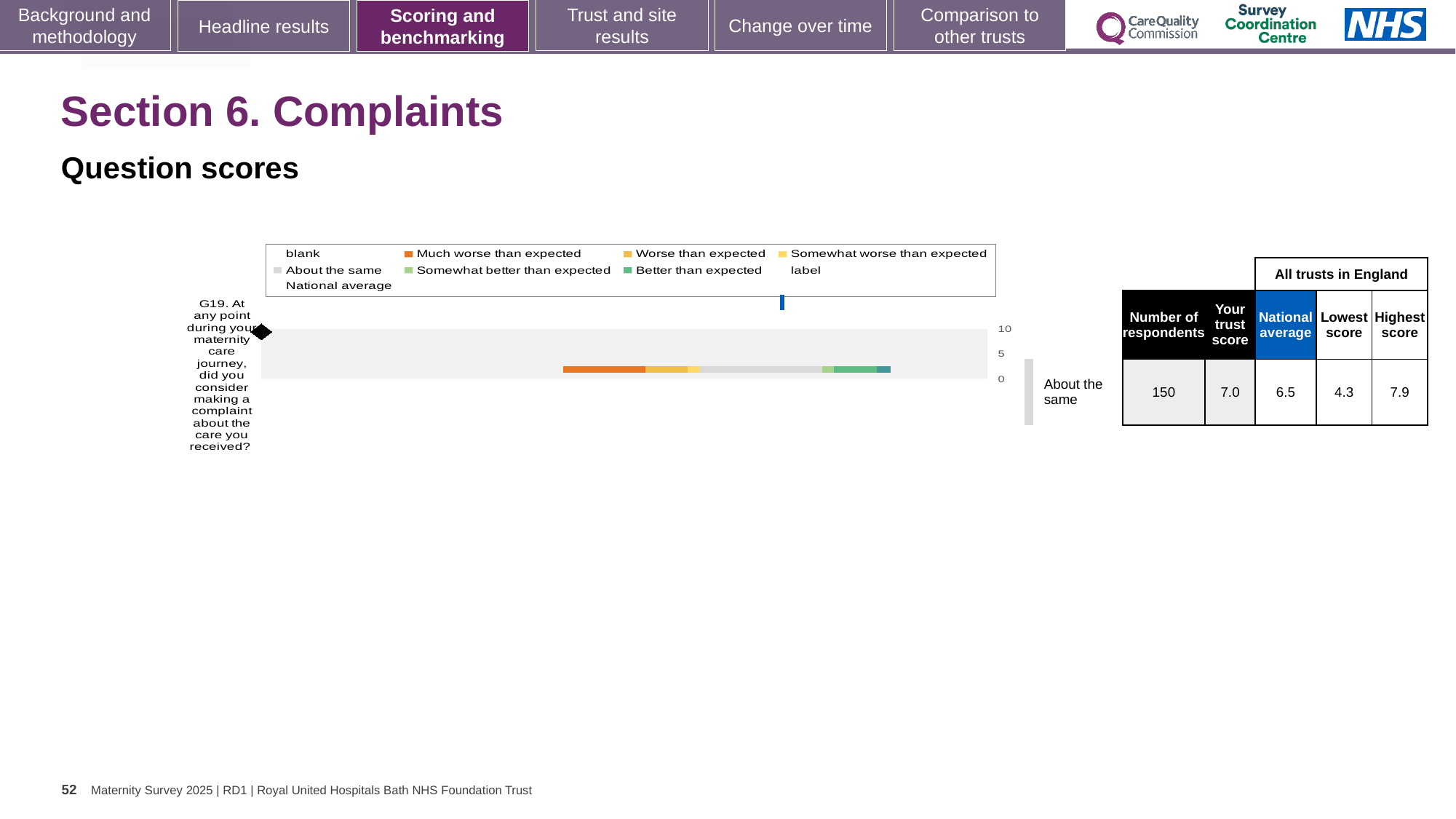
What is the difference between the highest and lowest scores among all trusts in England for question G19? 3.6 What kind of chart is shown for question G19? bar chart What is the highest score among all trusts in England for question G19? 7.9 What is the national average score for question G19? 6.5 What is the trust score for question G19? 7.0 Which is larger for question G19, the trust score or the national average? trust score How many respondents answered question G19? 150 How many survey questions are plotted in the chart? 1 What is the lowest score among all trusts in England for question G19? 4.3 Which benchmarking category is the trust's result for question G19 placed in? About the same What is the difference between the trust score and the national average for question G19? 0.5 Which legend entry is shown in orange? Much worse than expected